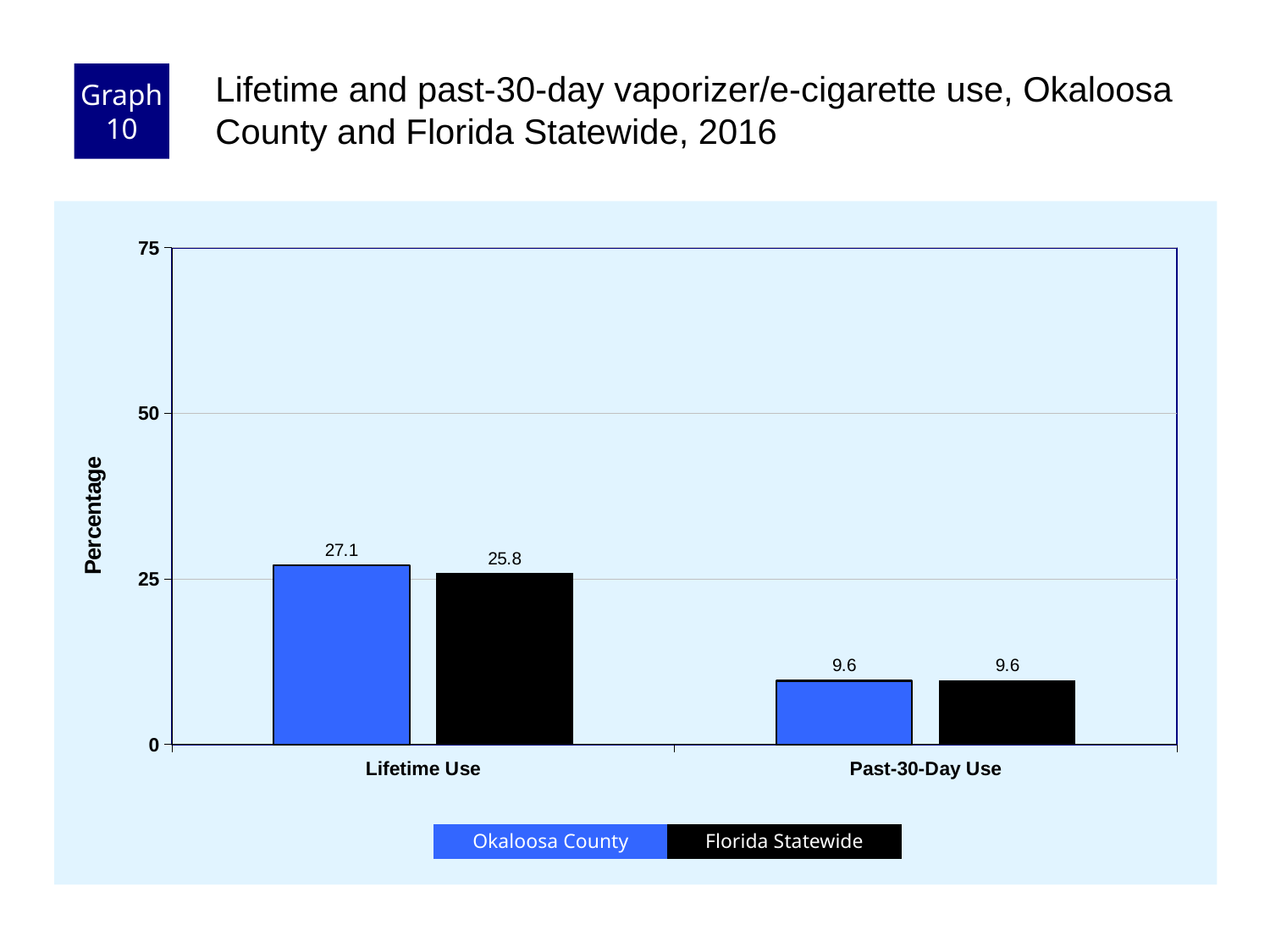
What is the Lifetime Use value for Florida Statewide? 25.8 What is the Past-30-Day Use value for Okaloosa County? 9.6 Is the Lifetime Use value for Okaloosa County greater or less than 25? greater For Lifetime Use, which is larger: Okaloosa County or Florida Statewide? Okaloosa County What is the difference between the Okaloosa County and Florida Statewide values for Lifetime Use? 1.3 What is the Past-30-Day Use value for Florida Statewide? 9.6 How many categories are shown on the x axis? 2 How many series does the legend list? 2 Which category has the lowest value for Florida Statewide? Past-30-Day Use Which category has the highest value for Okaloosa County? Lifetime Use What is the Lifetime Use value for Okaloosa County? 27.1 What kind of chart is shown on the slide? bar chart